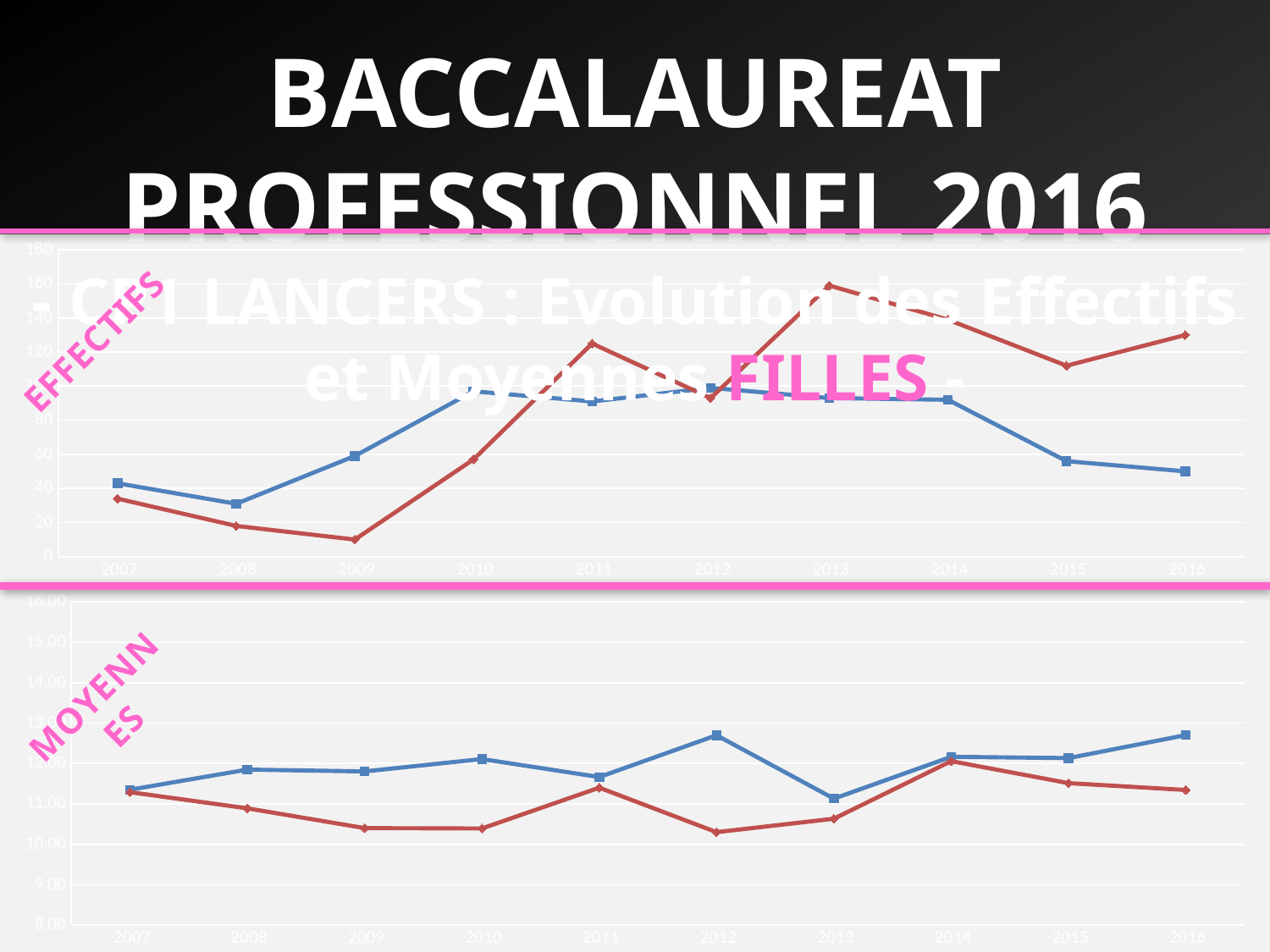
In the bottom chart (MOYENNES), which line has the larger value in 2009, the red line or the blue line? the blue line In the bottom chart (MOYENNES), is the value of the red line for 2012 greater or less than 11.00? less In the top chart (EFFECTIFS), does the red line rise or fall between 2009 and 2011? rise In the top chart (EFFECTIFS), in which year does the red line reach its highest value? 2013 In the top chart (EFFECTIFS), is the value of the red line for 2013 greater or less than 140? greater What kind of chart is the top chart (EFFECTIFS)? line chart How many charts are shown on the slide? 2 How many years are shown on the x axis of the top chart (EFFECTIFS)? 10 In the top chart (EFFECTIFS), which line has the larger value in 2016, the red line or the blue line? the red line In the top chart (EFFECTIFS), is the value of the blue line for 2016 greater or less than 60? less In the top chart (EFFECTIFS), in which year does the red line reach its lowest value? 2009